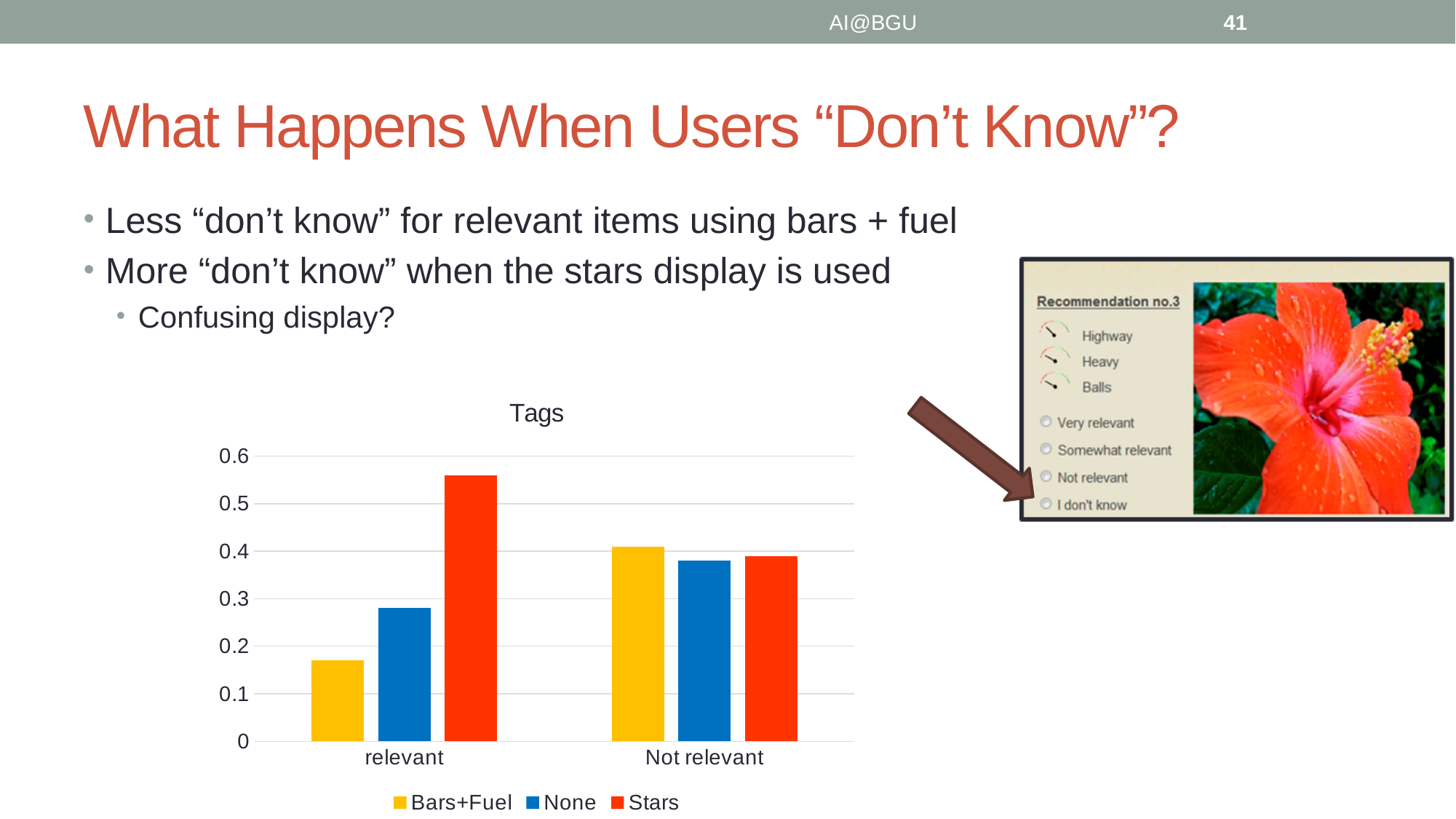
What is the title of the chart? Tags How many categories are shown on the x axis of the chart? 2 For the Bars+Fuel series, which category has the larger value: 'relevant' or 'Not relevant'? Not relevant Which series has the lowest value for the 'relevant' category? Bars+Fuel Is the value for Stars in the 'relevant' category greater or less than 0.5? greater Is the value for None in the 'relevant' category greater or less than 0.3? less How many series does the chart legend list? 3 Is the value for Bars+Fuel in the 'relevant' category greater or less than 0.2? less What kind of chart is shown on the slide? bar chart Which series has the highest value for the 'relevant' category? Stars For the Stars series, which category has the larger value: 'relevant' or 'Not relevant'? relevant Which series is shown in red in the chart? Stars